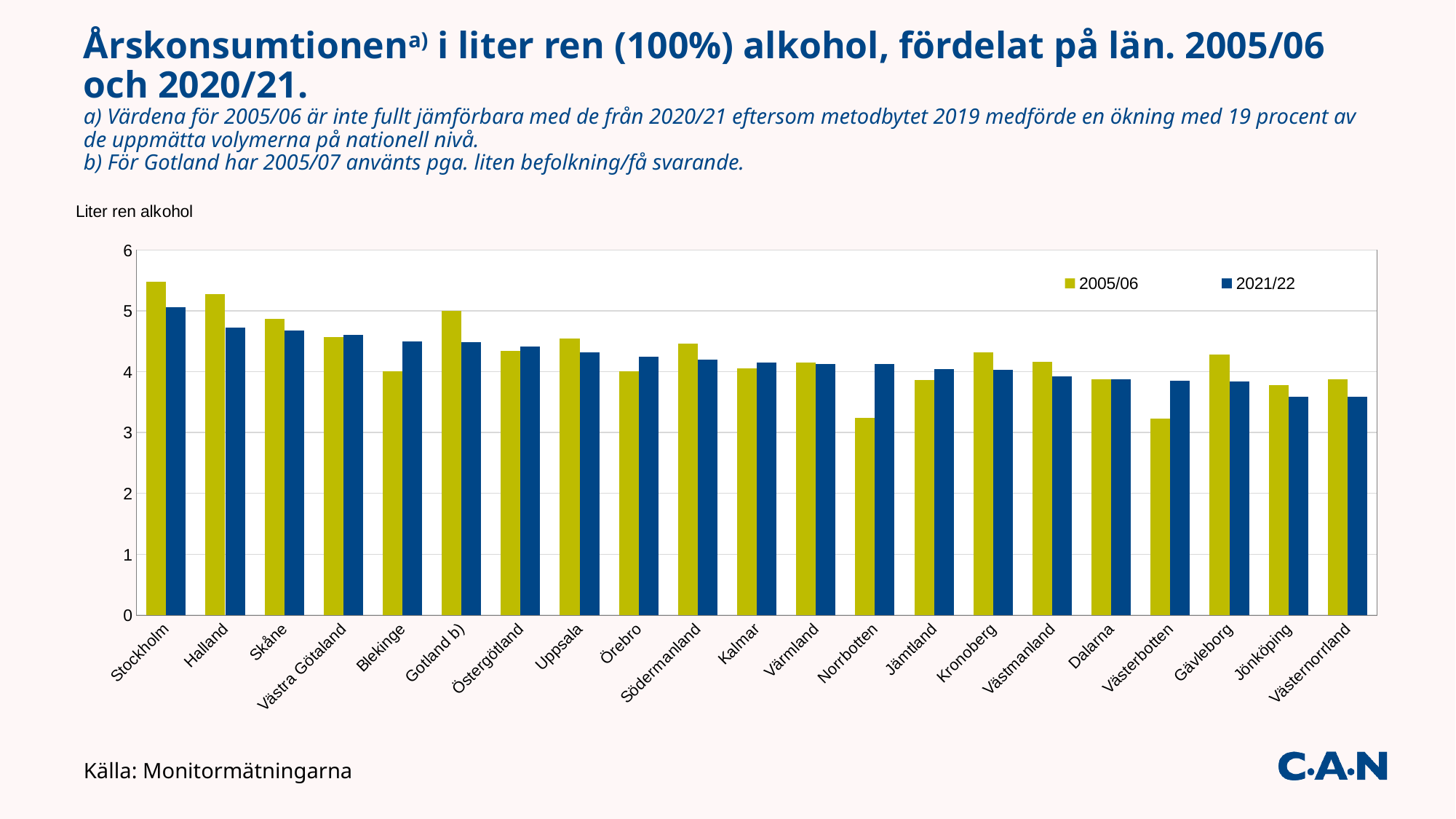
Is the 2021/22 value for Halland greater or less than 5? less What is the label on the y axis of the chart? Liter ren alkohol Is the 2005/06 value for Norrbotten greater or less than 4? less How many series does the legend list? 2 For Halland, which series has the larger value, 2005/06 or 2021/22? 2005/06 Is the 2005/06 value for Stockholm greater or less than 5? greater Which county has the highest value for the 2021/22 series? Stockholm Which county has the highest value for the 2005/06 series? Stockholm How many counties (län) are shown on the x axis? 21 For Norrbotten, which series has the larger value, 2005/06 or 2021/22? 2021/22 What kind of chart is shown on the slide? bar chart